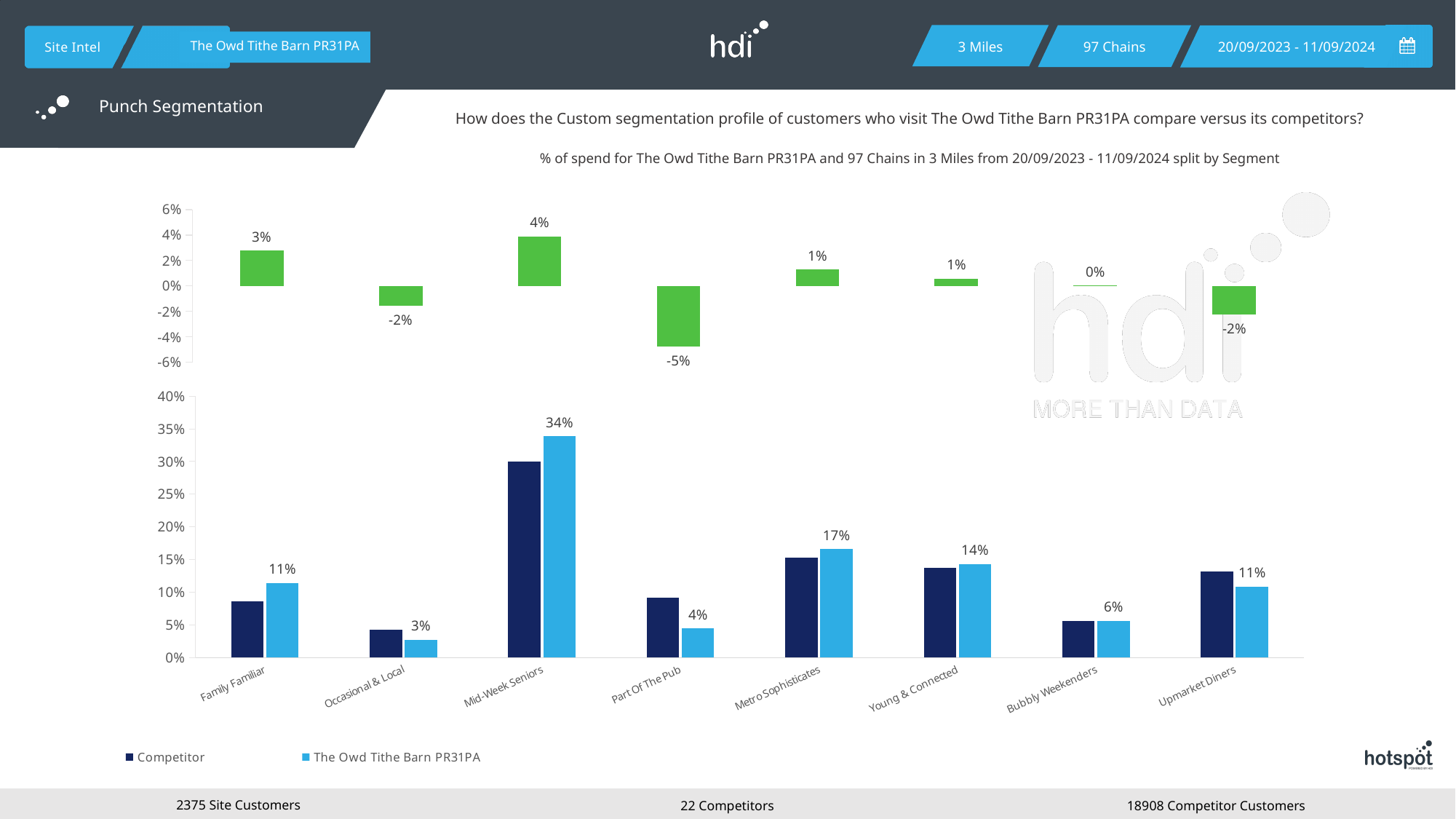
How many series does the legend of the bottom chart list? 2 In the bottom chart, is the Competitor value for Mid-Week Seniors greater or less than 25%? greater In the bottom chart, what is the value for The Owd Tithe Barn PR31PA in the Mid-Week Seniors segment? 34% In the bottom chart, what is the value for The Owd Tithe Barn PR31PA in the Metro Sophisticates segment? 17% In the top chart, what is the value for Part Of The Pub? -5% How many segments are shown on the x axis of the bottom chart? 8 In the top chart, which segment has the highest value? Mid-Week Seniors In the bottom chart, what is the difference between The Owd Tithe Barn PR31PA values for Young & Connected and Bubbly Weekenders? 8% In the bottom chart, which is larger for Family Familiar: the Competitor bar or The Owd Tithe Barn PR31PA bar? The Owd Tithe Barn PR31PA In the bottom chart, which segment has the lowest value for The Owd Tithe Barn PR31PA? Occasional & Local In the bottom chart, which segment has the highest value for The Owd Tithe Barn PR31PA? Mid-Week Seniors In the bottom chart, is the Competitor value for Part Of The Pub greater or less than 10%? less